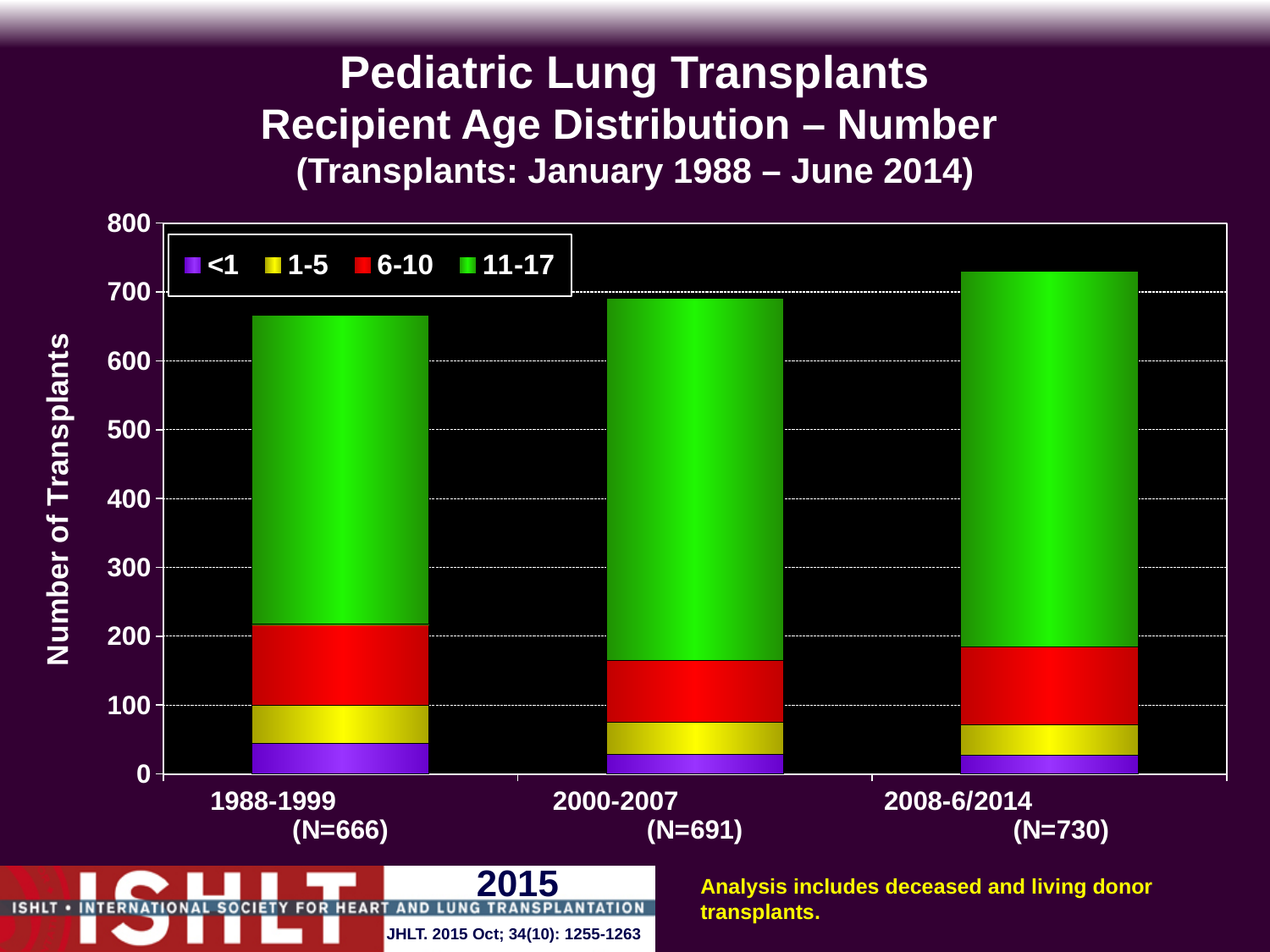
How many time periods (categories) are shown on the x axis? 3 What is the total number of transplants (N) for the 2008-6/2014 period? 730 Do the total numbers of transplants rise or fall across the periods from 1988-1999 to 2008-6/2014? Rise What is the total number of transplants (N) for the 1988-1999 period? 666 What is the difference between the total transplants in 2008-6/2014 and in 1988-1999? 64 How many age groups does the legend list? 4 Is the total height of the 2008-6/2014 bar greater or less than 700? greater What is the label of the y axis? Number of Transplants Which period has the lowest total number of transplants? 1988-1999 Which period has the highest total number of transplants? 2008-6/2014 What kind of chart is shown on the slide? Stacked bar chart What is the total number of transplants (N) for the 2000-2007 period? 691